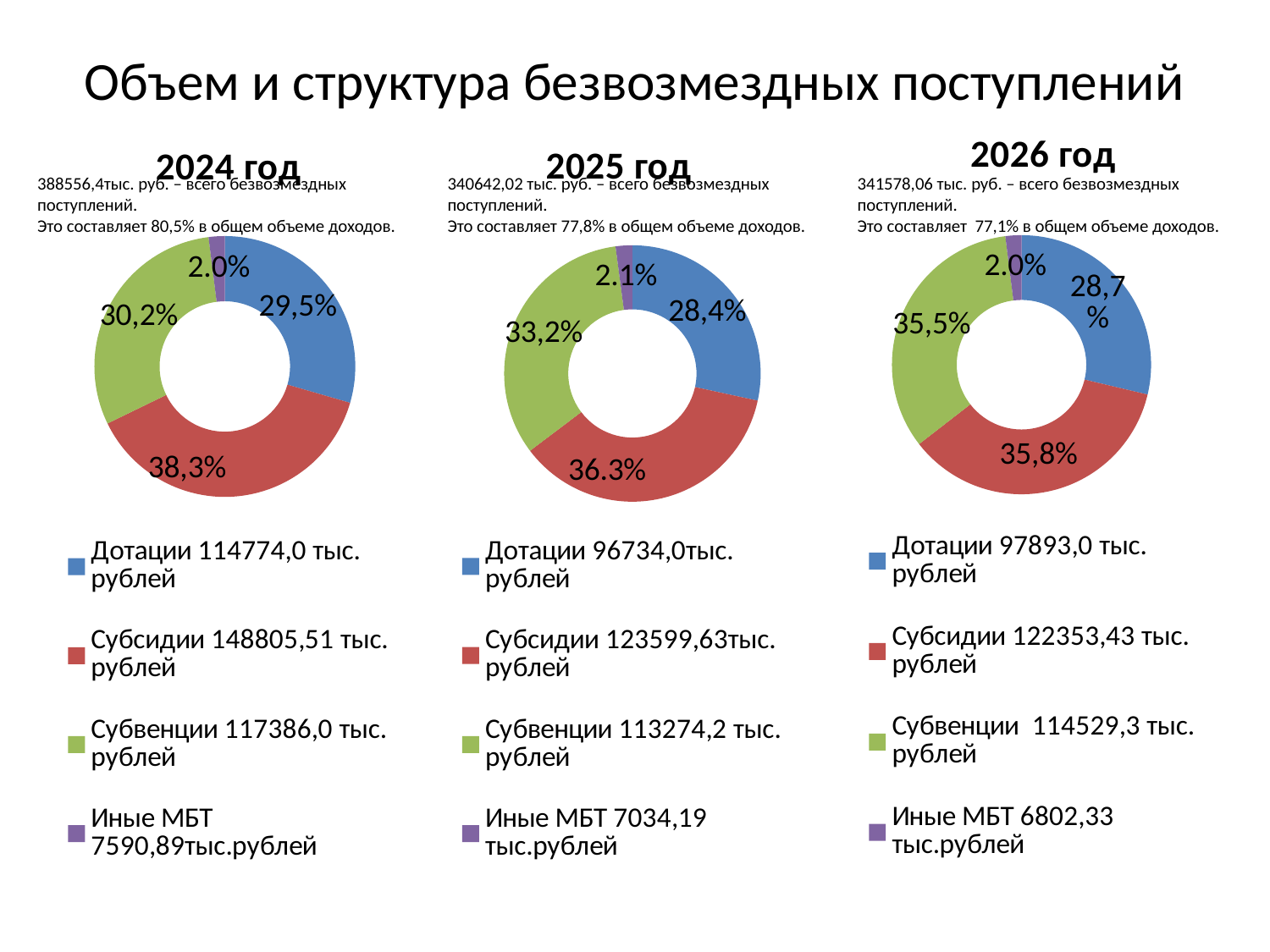
In the 2026 год chart, what is the value shown in the legend for Субвенции? 114529,3 тыс. рублей In the 2024 год chart, which category has the smallest share? Иные МБТ What kind of chart is used for the 2024 год chart? doughnut chart In the 2025 год chart, which is larger, the share of Дотации or the share of Субсидии? Субсидии In the 2024 год chart, what share does Субсидии have? 38,3% How many categories does the legend of the 2026 год chart list? 4 In the 2026 год chart, what share does Иные МБТ have? 2.0% In the 2025 год chart, what share does Субвенции have? 33,2% In the 2024 год chart, what is the difference between the shares of Субсидии and Дотации? 8,8% What colour represents Субвенции in the 2025 год chart? green In the 2025 год chart, what is the value shown in the legend for Дотации? 96734,0 тыс. рублей In the 2024 год chart, which category has the largest share? Субсидии